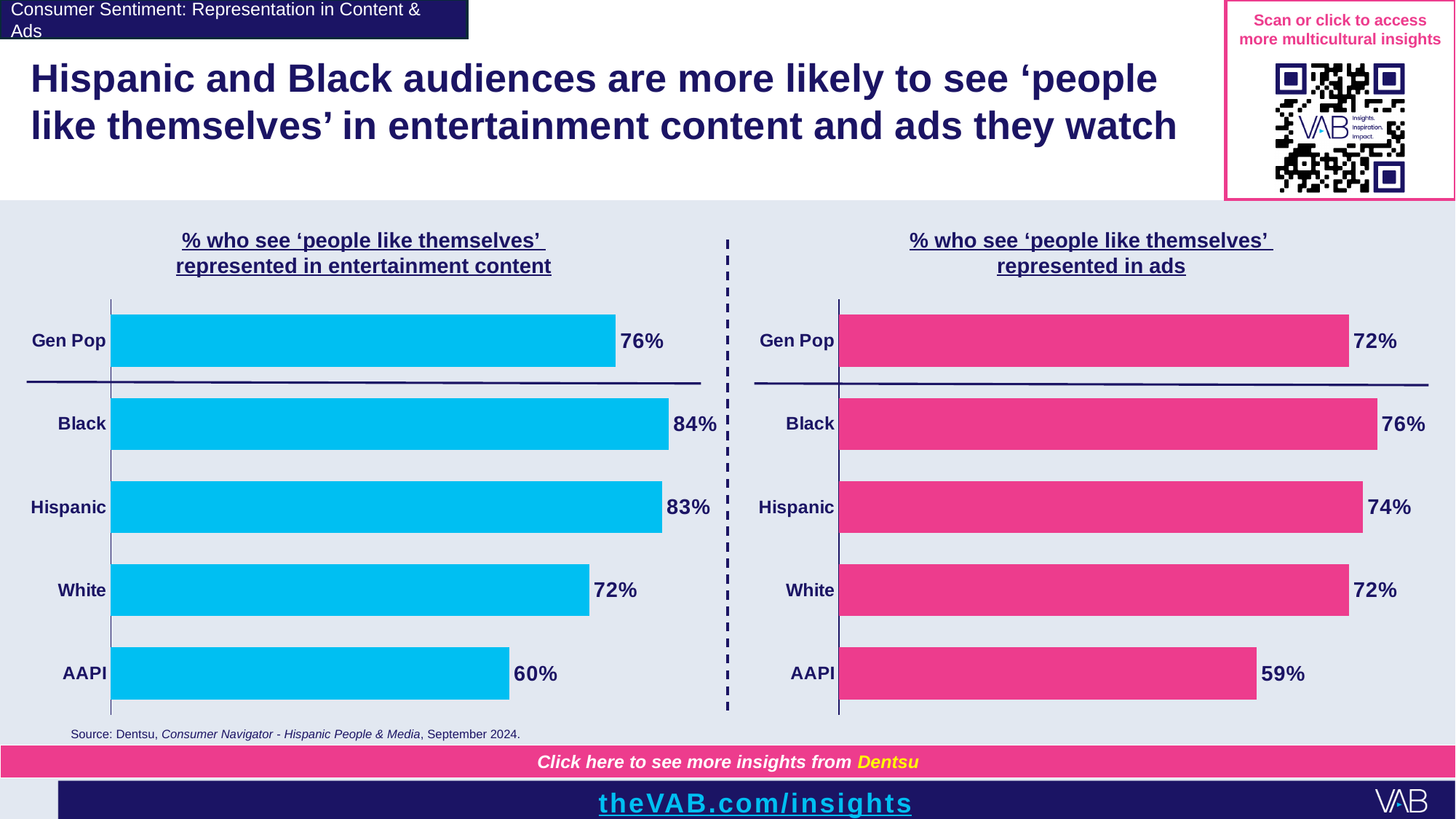
In the chart '% who see 'people like themselves' represented in entertainment content', which category has the highest value? Black In the chart '% who see 'people like themselves' represented in entertainment content', which is larger, the value for Hispanic or the value for White? Hispanic What kind of chart is '% who see 'people like themselves' represented in entertainment content'? Bar chart In the chart '% who see 'people like themselves' represented in ads', what is the value for Hispanic? 74% In the chart '% who see 'people like themselves' represented in ads', what is the difference between the values for Black and Gen Pop? 4 percentage points In the chart '% who see 'people like themselves' represented in ads', what is the value for AAPI? 59% What is the value for Gen Pop in the chart '% who see 'people like themselves' represented in entertainment content'? 76% In the chart '% who see 'people like themselves' represented in entertainment content', what is the difference between the values for Black and AAPI? 24 percentage points In the chart '% who see 'people like themselves' represented in entertainment content', what is the value for Black? 84% How many categories are shown in the chart '% who see 'people like themselves' represented in ads'? 5 What colour are the bars in the chart '% who see 'people like themselves' represented in ads'? Pink In the chart '% who see 'people like themselves' represented in ads', which category has the lowest value? AAPI